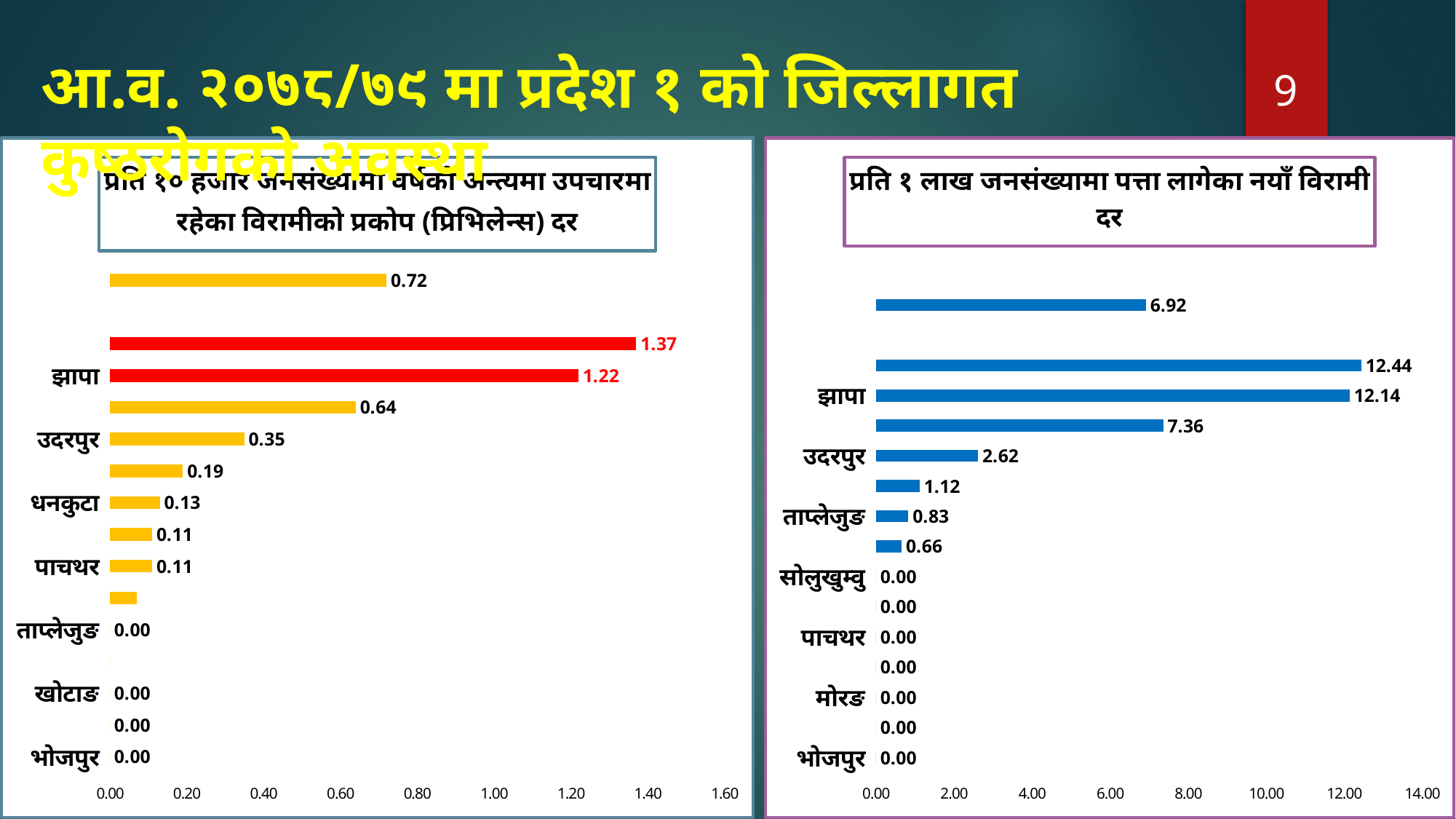
In the left chart, which has the larger value, झापा or उदरपुर? झापा In the left chart, what is the value for उदरपुर? 0.35 In the left chart (प्रति १० हजार जनसंख्यामा ... प्रिभिलेन्स दर), what is the value for झापा? 1.22 In the left chart, what is the value for धनकुटा? 0.13 In the right chart, what is the value for उदरपुर? 2.62 What type of chart is the right chart on the slide? Bar chart In the right chart, what is the highest value shown on any bar? 12.44 In the left chart, what colour is the bar for झापा? Red In the right chart, what is the difference between the values for झापा and उदरपुर? 9.52 In the left chart, what is the highest value shown on any bar? 1.37 In the right chart, what is the value for ताप्लेजुङ? 0.83 In the right chart (प्रति १ लाख जनसंख्यामा पत्ता लागेका नयाँ विरामी दर), what is the value for झापा? 12.14